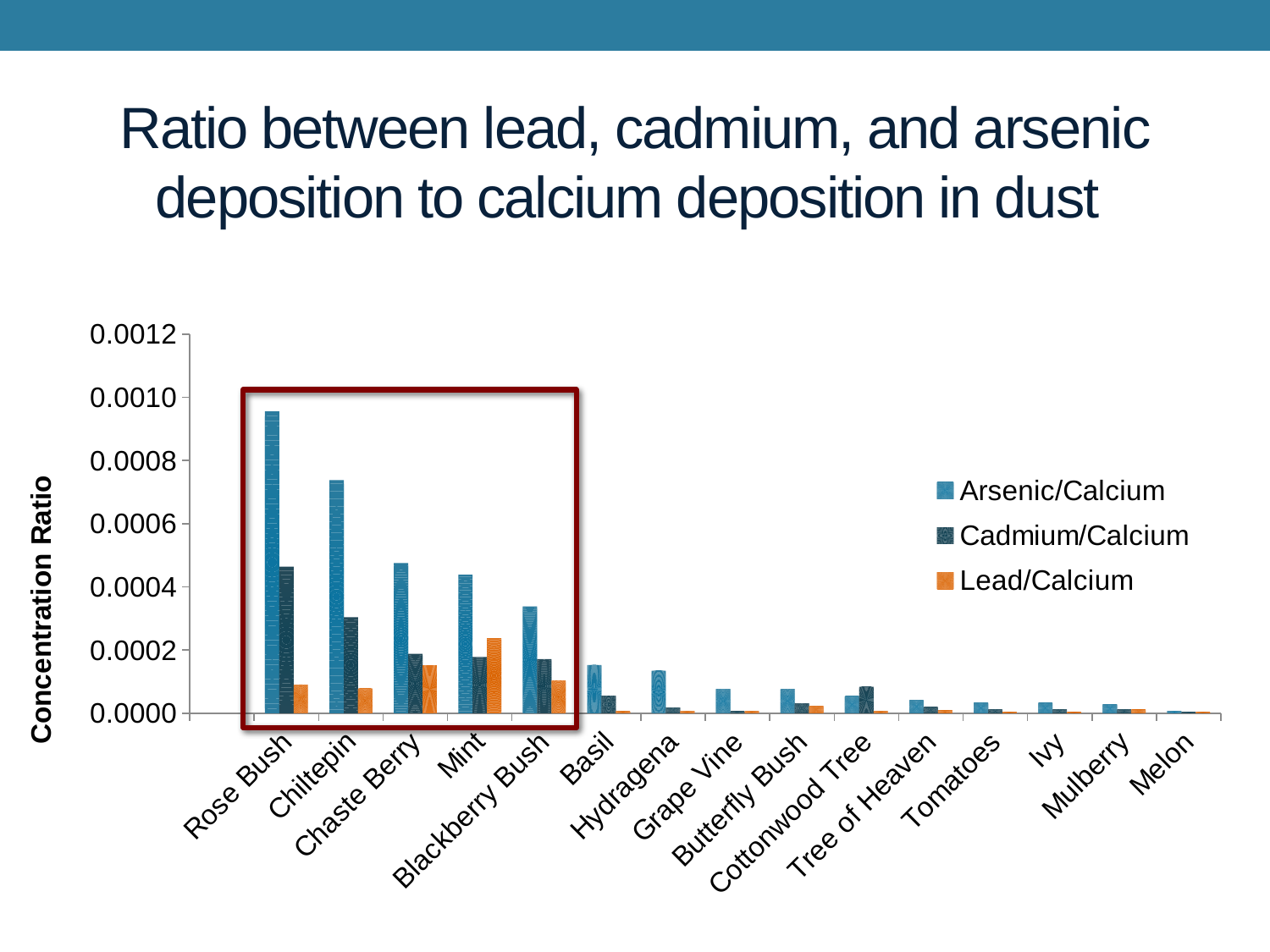
Which plant has the highest Arsenic/Calcium ratio? Rose Bush How many plant categories are shown on the x axis? 15 Which plant has the highest Lead/Calcium ratio? Mint Which plant has the highest Cadmium/Calcium ratio? Rose Bush Which is larger, the Arsenic/Calcium value for Rose Bush or for Chiltepin? Rose Bush Is the Lead/Calcium value for Rose Bush greater or less than 0.0002? less What kind of chart is shown on the slide? bar chart Is the Arsenic/Calcium value for Blackberry Bush greater or less than 0.0004? less Is the Arsenic/Calcium value for Rose Bush greater or less than 0.0008? greater How many series does the legend list? 3 What is the title of the y axis? Concentration Ratio Do the Arsenic/Calcium values generally rise or fall moving from left to right along the x axis? fall